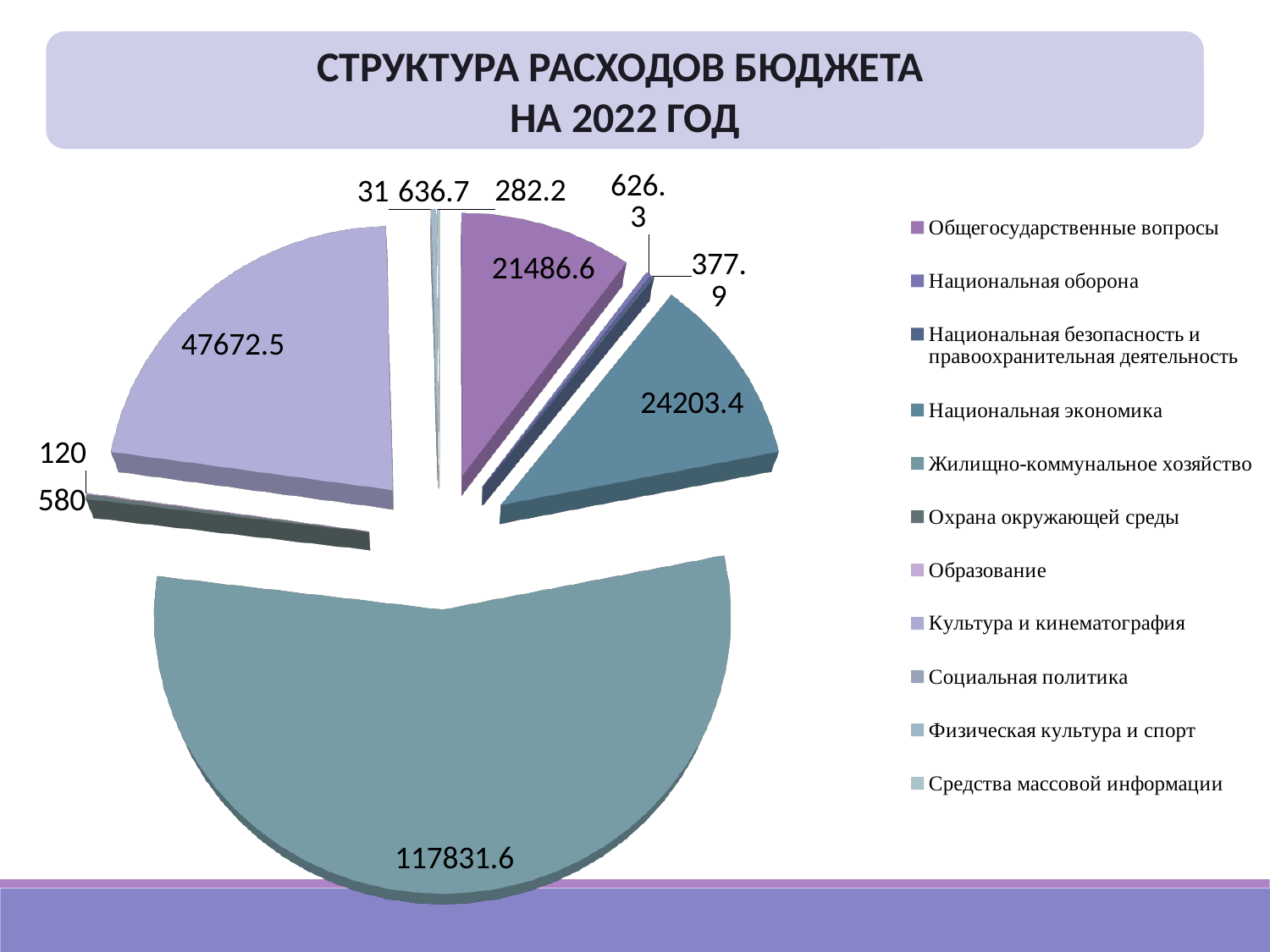
What is the difference between the values for Культура и кинематография and Общегосударственные вопросы? 26185.9 Which is larger, the value for Национальная экономика or the value for Общегосударственные вопросы? Национальная экономика Which is larger, the value for Культура и кинематография or the value for Национальная экономика? Культура и кинематография What is the title of the chart on the slide? СТРУКТУРА РАСХОДОВ БЮДЖЕТА НА 2022 ГОД What is the difference between the values for Национальная экономика and Общегосударственные вопросы? 2716.8 What kind of chart is shown on the slide? pie chart How many categories does the legend of the pie chart list? 11 What is the value shown for Национальная экономика? 24203.4 What is the value shown for Культура и кинематография? 47672.5 What is the value shown for Общегосударственные вопросы? 21486.6 What is the value shown for Жилищно-коммунальное хозяйство? 117831.6 Which category has the largest slice in the pie chart? Жилищно-коммунальное хозяйство